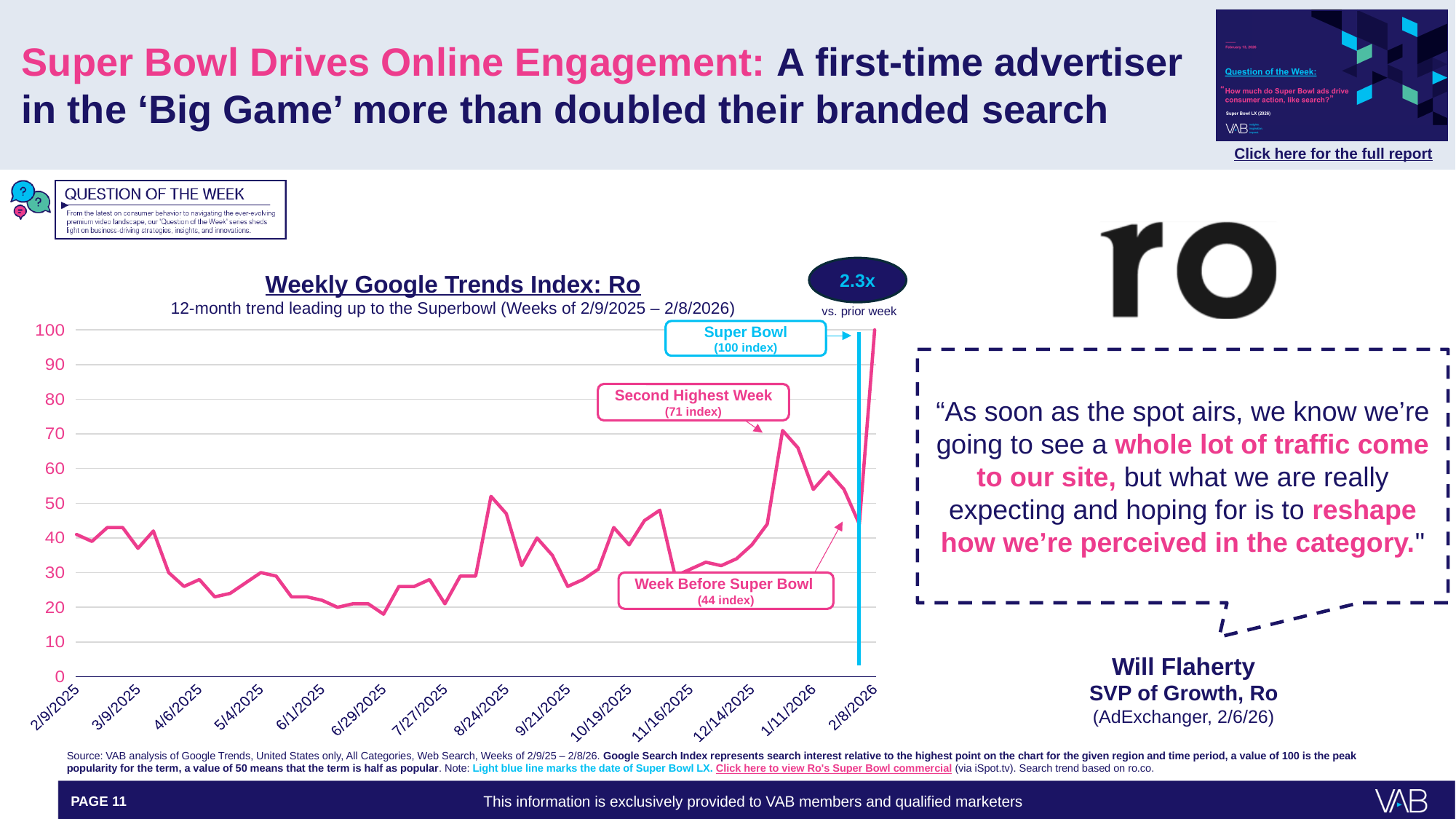
Does the index rise or fall from 12/14/2025 to 2/8/2026? Rise Which is larger, the index for the second highest week or the index for the week before the Super Bowl? Second highest week What index value is labeled for the second highest week? 71 index How many date labels are shown on the x axis? 14 What is the difference between the Super Bowl week index and the week before the Super Bowl index? 56 What is the difference between the Super Bowl week index and the second highest week index? 29 Is the index value for the week of 2/9/2025 greater or less than 50? less What multiplier vs. the prior week is shown in the oval above the chart? 2.3x What index value is labeled for the week before the Super Bowl? 44 index What index value does the chart show for the Super Bowl week? 100 index Which week has the highest index value on the chart? Super Bowl week (2/8/2026) What kind of chart is the 'Weekly Google Trends Index: Ro' chart? Line chart